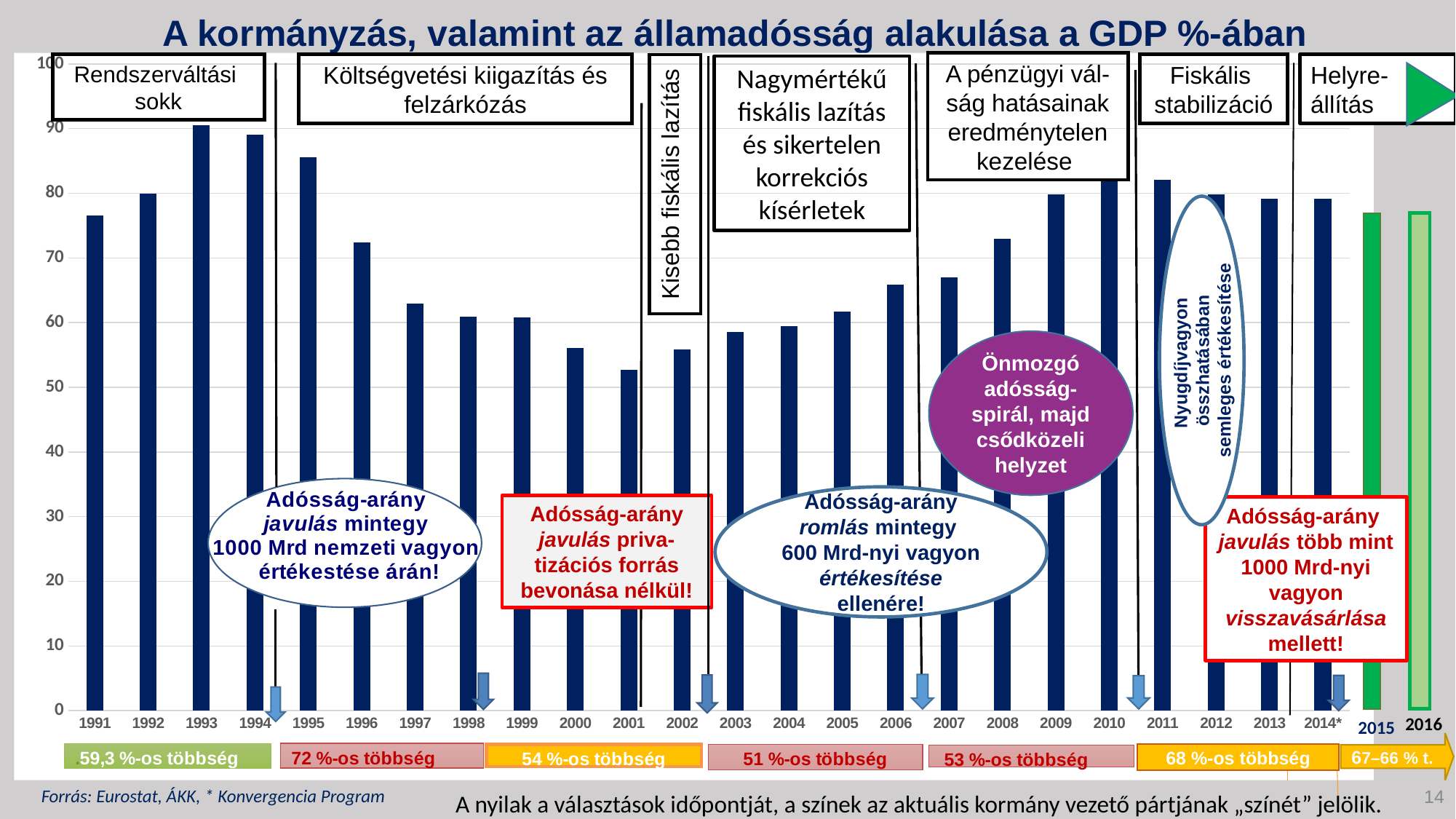
Is the value for 2001 greater or less than 60? less Is the value for 1993 greater or less than 80? greater Do the values rise or fall from 2001 to 2010? rise Is the value for 2006 greater or less than 60? greater Which year has the highest debt-to-GDP value on the chart? 1993 What kind of chart is shown on the slide? bar chart Do the values rise or fall from 1995 to 2001? fall Which year has the larger value, 2008 or 2009? 2009 Which year has the lowest debt-to-GDP value on the chart? 2001 How many years (bars) are plotted on the chart? 24 What is the title of the chart? A kormányzás, valamint az államadósság alakulása a GDP %-ában